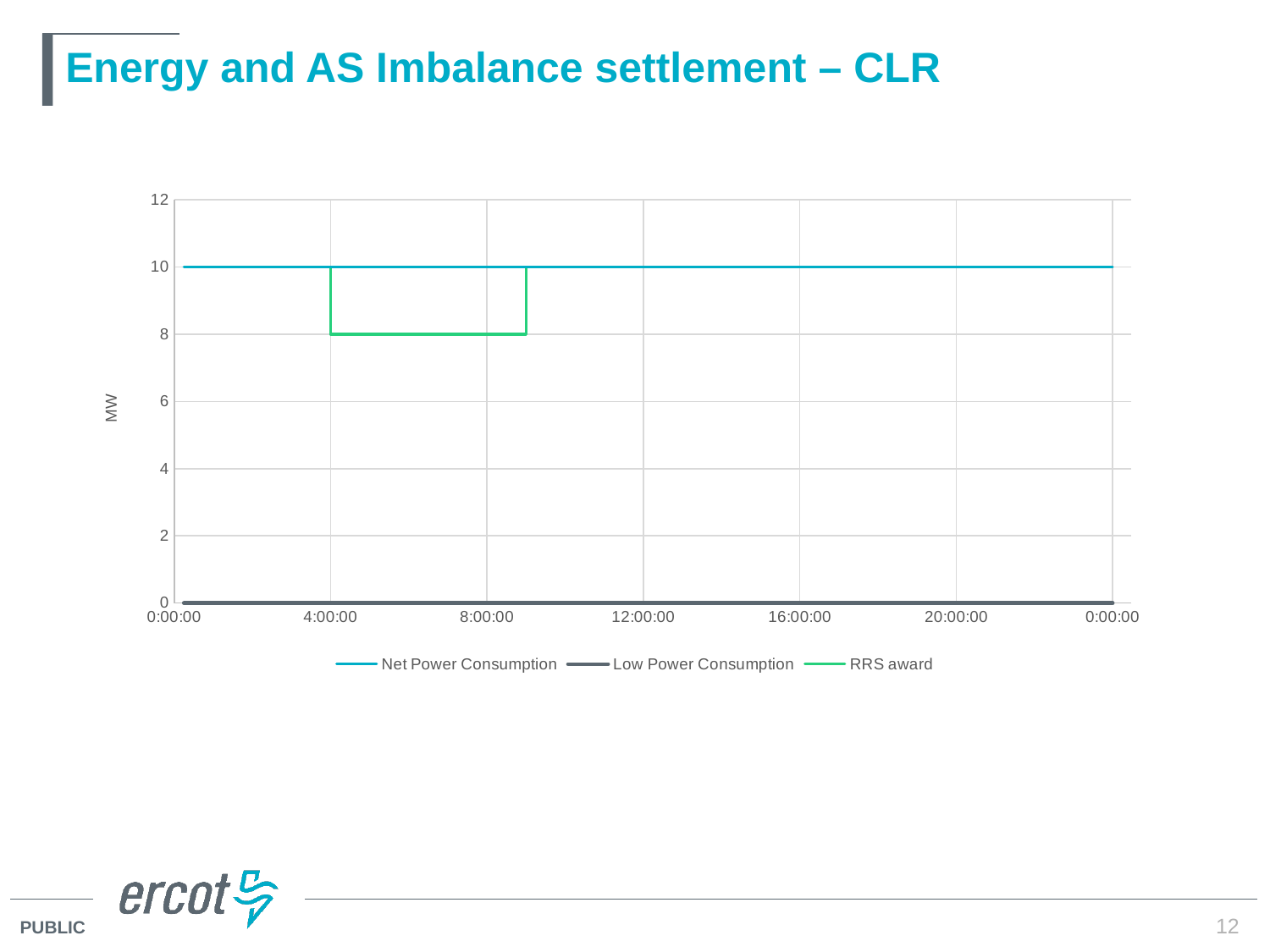
What is the label on the vertical axis? MW What is the value of RRS award at 6:00:00? 8 How many series does the legend list? 3 What is the title of the slide containing the chart? Energy and AS Imbalance settlement – CLR Does Net Power Consumption rise, fall, or stay flat across the day? Stays flat Is the value for Net Power Consumption at 20:00:00 greater or less than 6? greater At 6:00:00, which is higher, Net Power Consumption or RRS award? Net Power Consumption What is the value of Net Power Consumption at 12:00:00? 10 Which series has the lowest value at 6:00:00? Low Power Consumption What is the value of Low Power Consumption at 16:00:00? 0 What kind of chart is shown on the slide? Line chart What is the difference between Net Power Consumption and RRS award at 6:00:00? 2